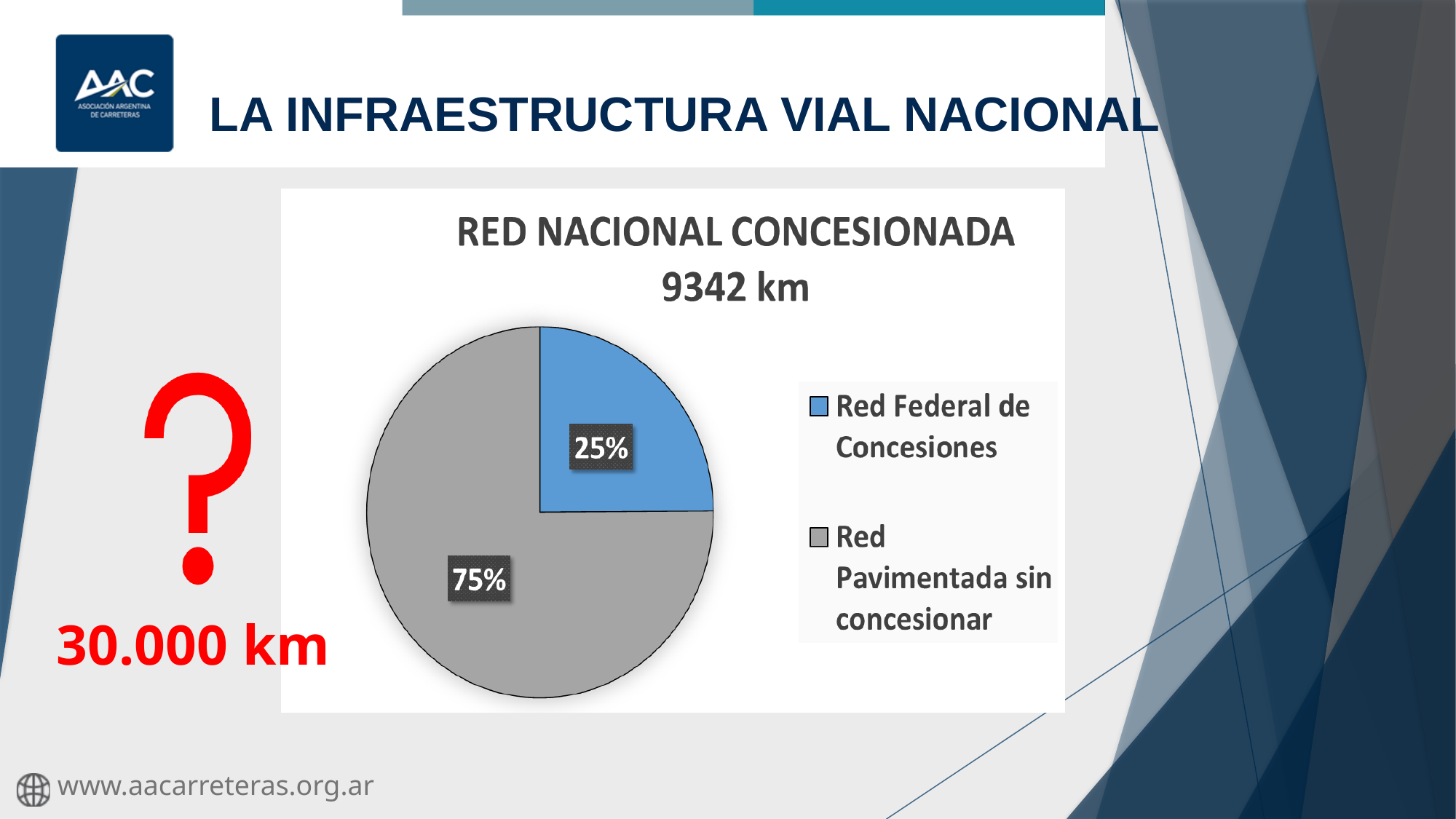
What colour is the slice for Red Federal de Concesiones? Blue What is the title of the chart? RED NACIONAL CONCESIONADA 9342 km What share of the pie does Red Pavimentada sin concesionar represent? 75% How many entries does the legend list? 2 Which category has the largest slice of the pie? Red Pavimentada sin concesionar Which is larger: Red Federal de Concesiones or Red Pavimentada sin concesionar? Red Pavimentada sin concesionar Which category has the smallest slice of the pie? Red Federal de Concesiones What type of chart is shown on the slide? Pie chart What share of the pie does Red Federal de Concesiones represent? 25% What is the difference in percentage points between Red Pavimentada sin concesionar and Red Federal de Concesiones? 50 What total length in km is given in the chart title? 9342 km How many categories does the pie chart show? 2